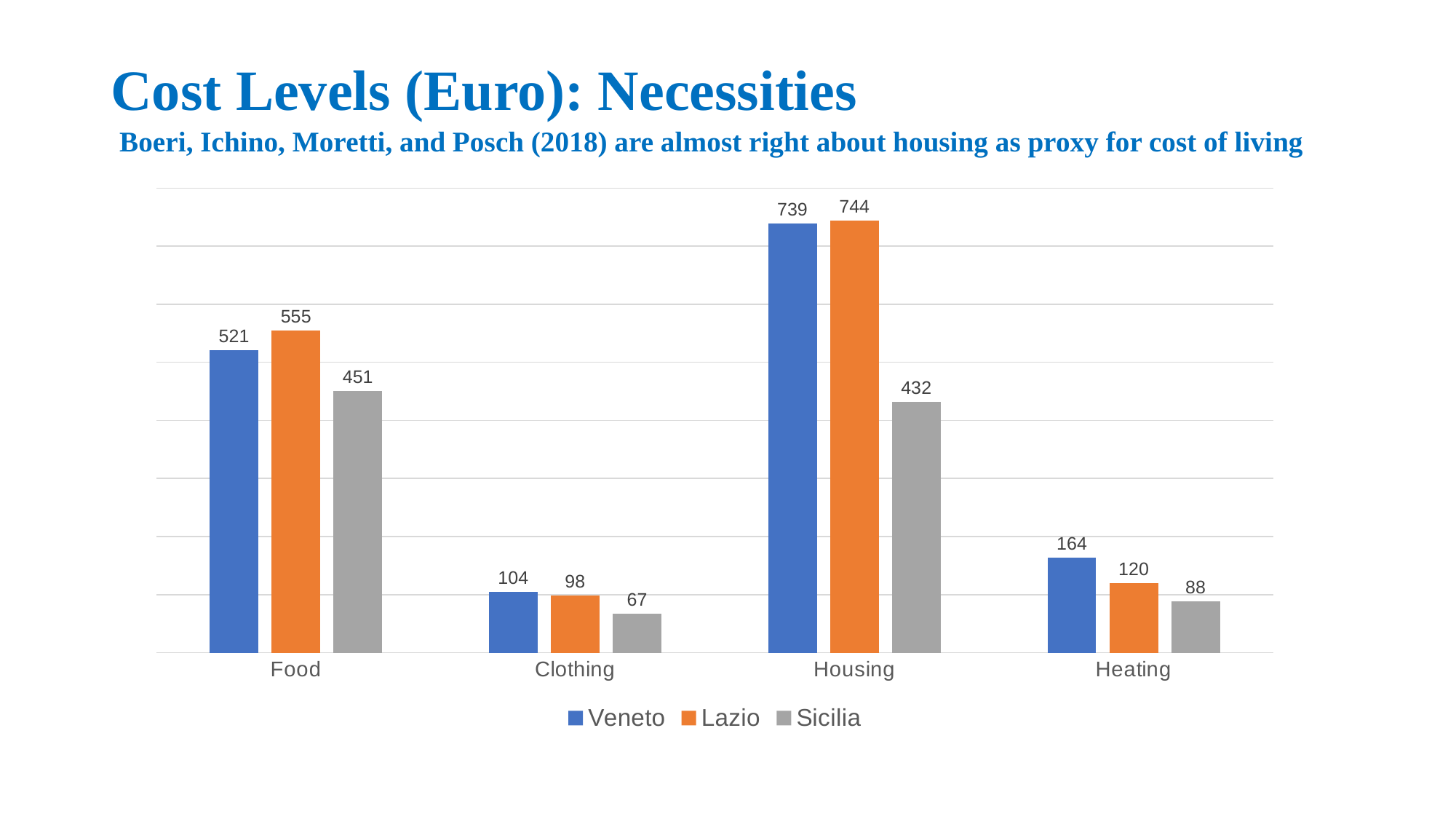
What kind of chart is shown on the slide? Bar chart What is the difference between the Lazio and Sicilia values in the Food category? 104 Which colour represents Sicilia in the legend? Grey How many series does the legend list? 3 Which is larger in the Clothing category, the value for Veneto or the value for Lazio? Veneto How many categories are shown on the x axis? 4 Which category has the lowest value for Sicilia? Clothing What is the difference between the Veneto and Lazio values in the Heating category? 44 What is the value for Veneto in the Heating category? 164 What is the value for Lazio in the Food category? 555 What is the value for Sicilia in the Housing category? 432 Which category has the highest value for Veneto? Housing